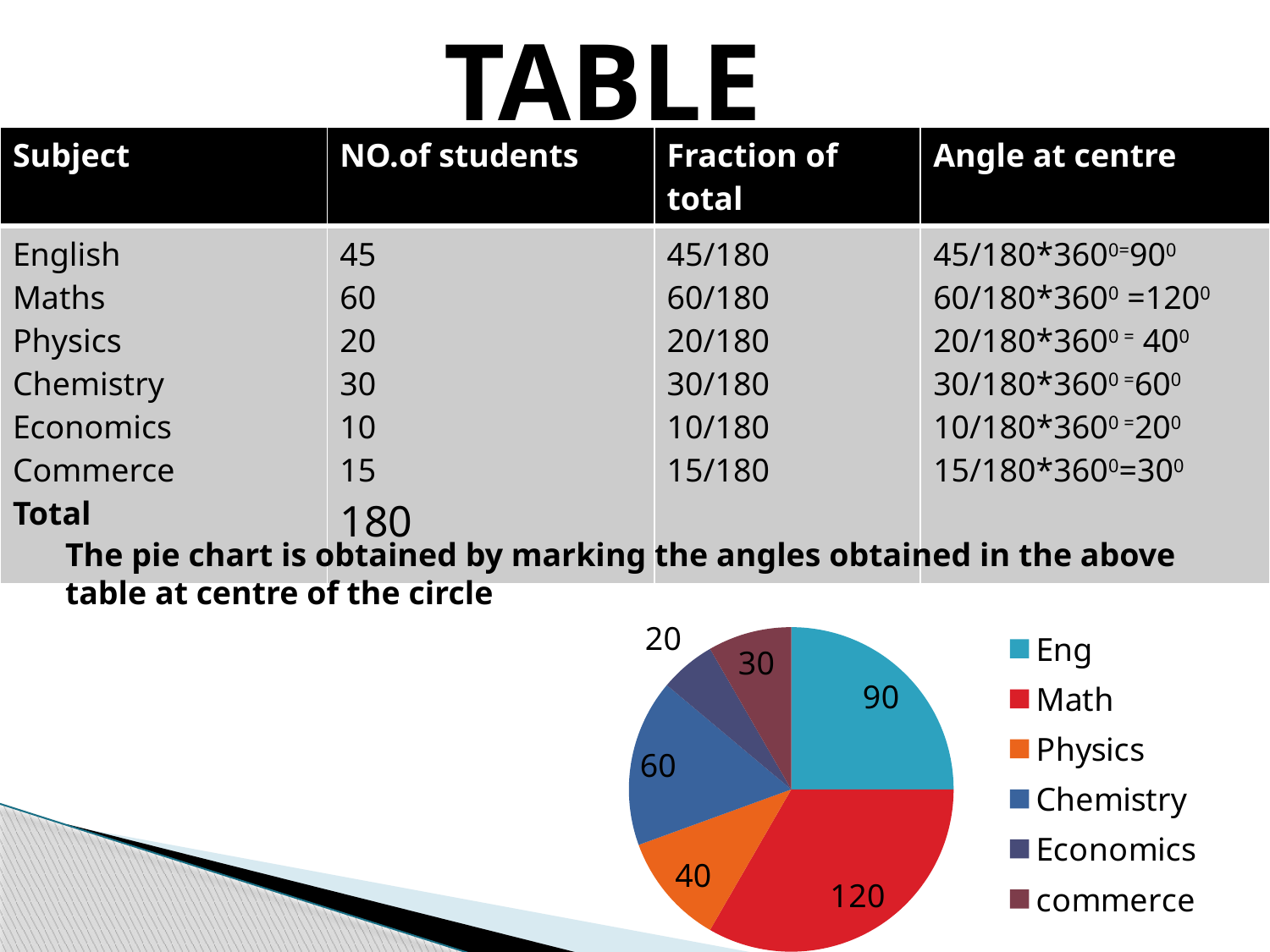
Which slice of the pie chart has the smallest value? Economics What share of the pie chart does the Eng slice represent? 25% What is the value shown for the Economics slice of the pie chart? 20 What type of chart is shown on the slide? pie chart What is the value shown for the Physics slice of the pie chart? 40 What colour is the Math slice in the pie chart? red What is the difference between the Math and Eng values in the pie chart? 30 Which is larger in the pie chart, Chemistry or Physics? Chemistry What is the value shown for the Eng slice of the pie chart? 90 Which slice of the pie chart has the largest value? Math How many slices does the pie chart have? 6 What is the value shown for the Math slice of the pie chart? 120